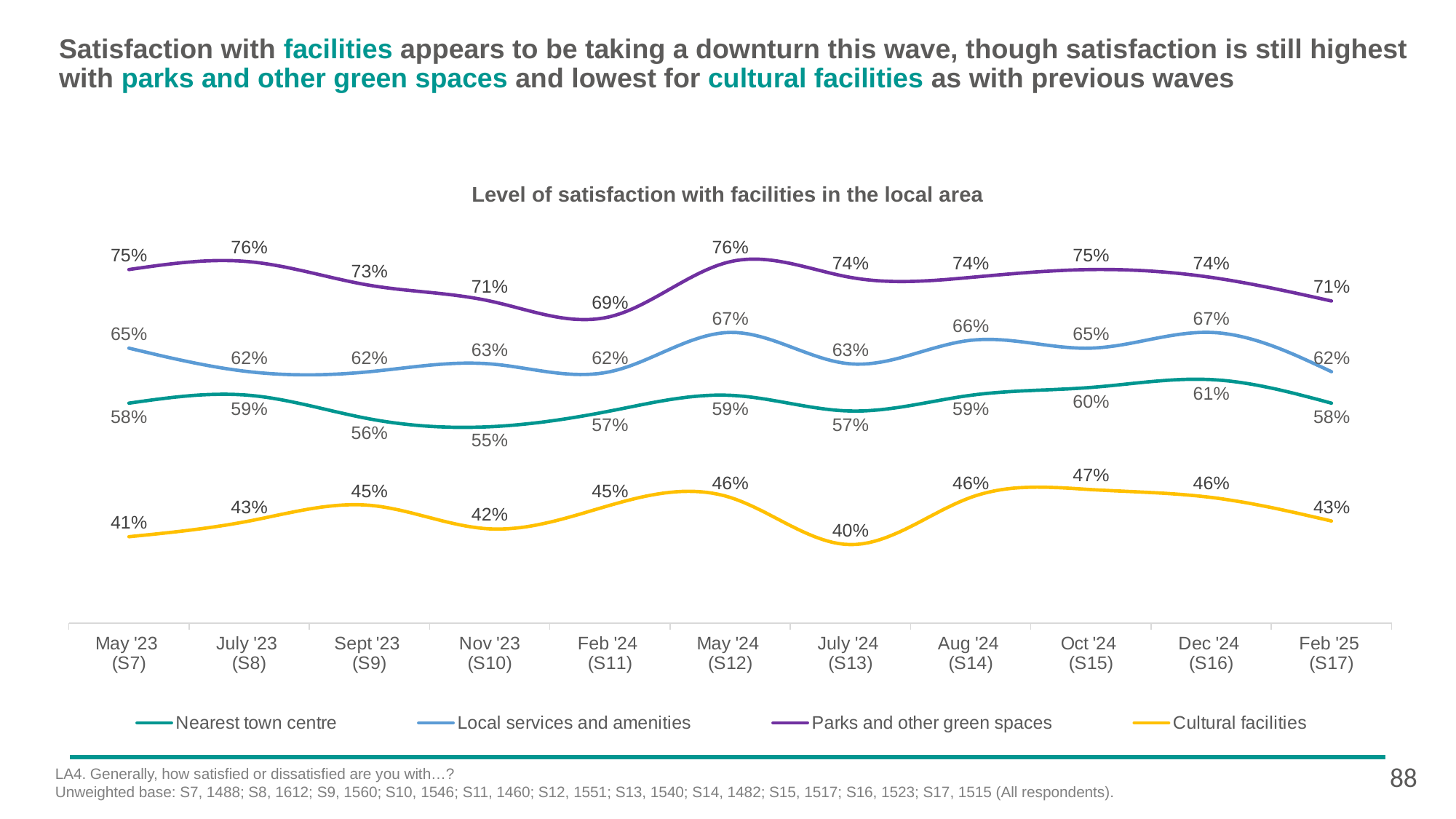
What is the satisfaction value for Cultural facilities in July '24 (S13)? 40% Which series has the higher value in Feb '24 (S11): Local services and amenities or Nearest town centre? Local services and amenities At which time point is satisfaction with Cultural facilities highest? Oct '24 (S15) What is the satisfaction value for Nearest town centre in Dec '24 (S16)? 61% What type of chart is shown on the slide? Line chart What is the satisfaction value for Parks and other green spaces in Feb '25 (S17)? 71% What is the difference between Parks and other green spaces and Cultural facilities in Feb '25 (S17)? 28 percentage points At which time point is satisfaction with Nearest town centre lowest? Nov '23 (S10) How many time points are shown on the x axis? 11 What is the title of the chart? Level of satisfaction with facilities in the local area How many series does the legend list? 4 What is the satisfaction value for Local services and amenities in May '24 (S12)? 67%